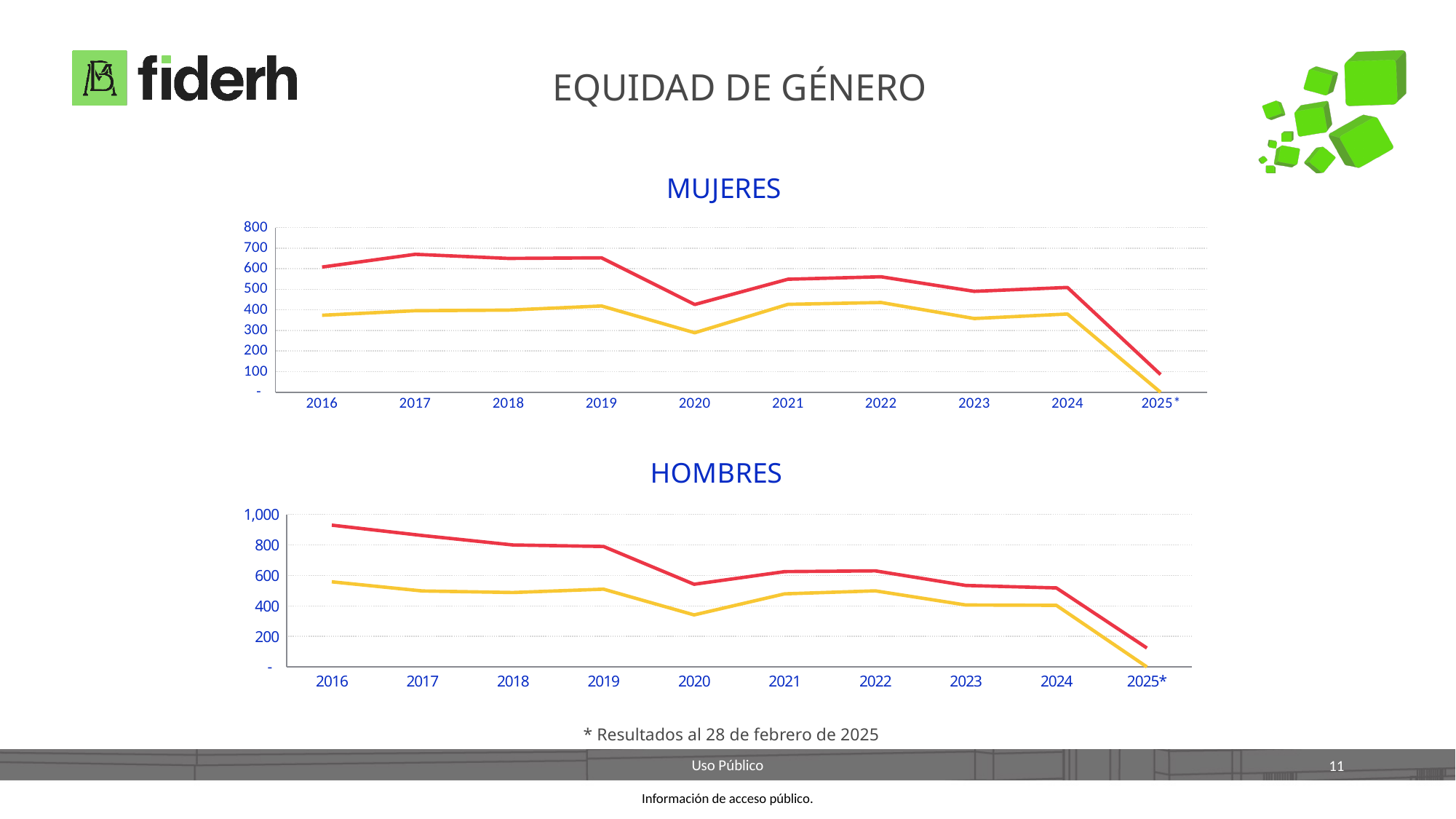
What is the title of the upper chart on the slide? MUJERES In the MUJERES chart, is the red line's value for 2016 greater or less than 500? greater In the HOMBRES chart, which year has the highest value on the red line? 2016 How many years are shown on the x axis of the HOMBRES chart? 10 In the HOMBRES chart, is the red line's value higher in 2019 or in 2020? 2019 In the HOMBRES chart, is the red line's value for 2016 greater or less than 800? greater In the MUJERES chart, which year has the lowest value on the red line? 2025* How many lines are plotted on the MUJERES chart? 2 In the HOMBRES chart, does the red line generally rise or fall from 2016 to 2025*? fall In the HOMBRES chart, is the yellow line's value for 2020 greater or less than 400? less What kind of chart is the MUJERES chart? line chart